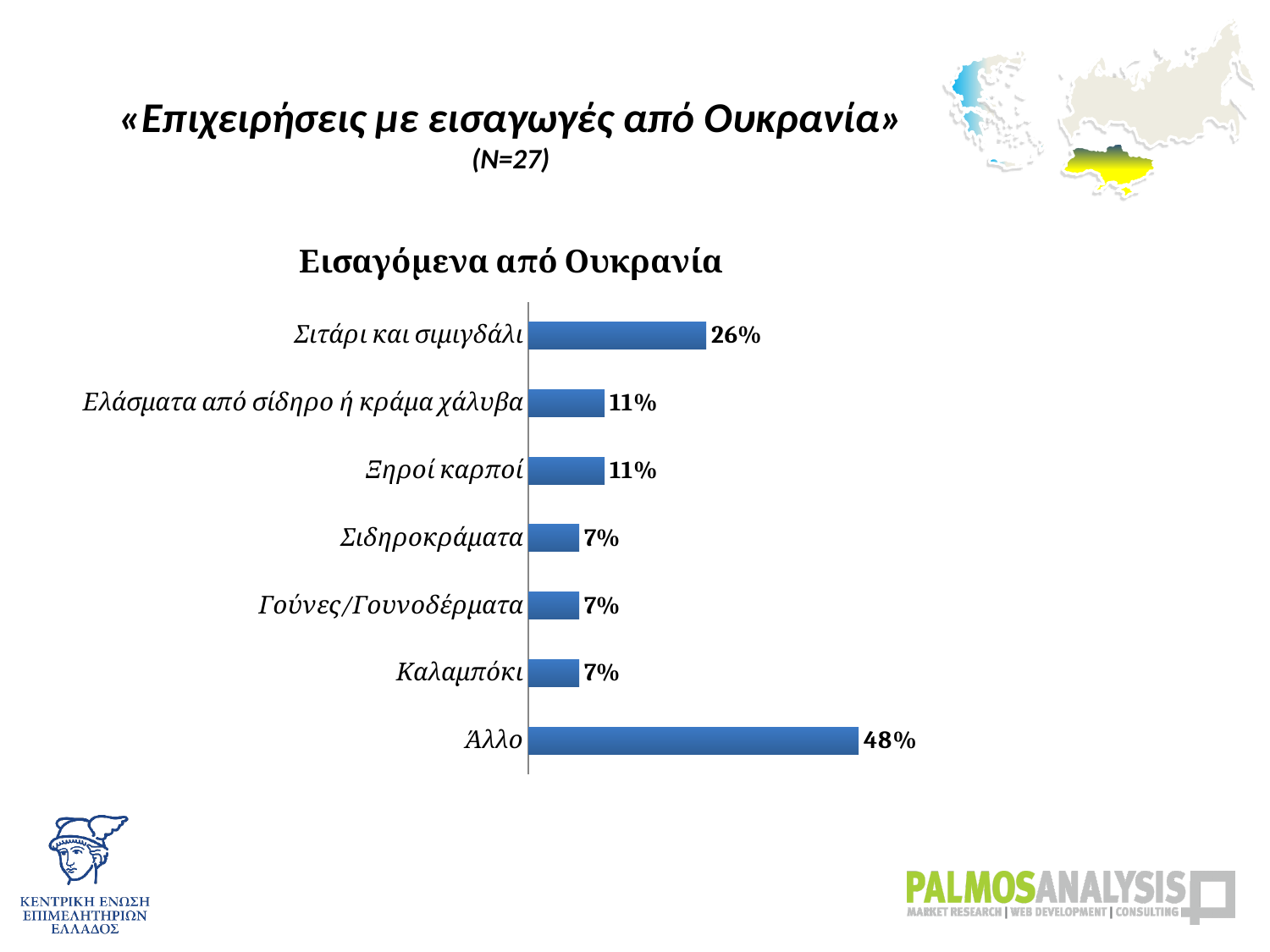
How many categories are shown in the chart? 7 Which is larger, the value for Σιτάρι και σιμιγδάλι or the value for Ξηροί καρποί? Σιτάρι και σιμιγδάλι What is the title of the chart? Εισαγόμενα από Ουκρανία Which category has the highest value? Άλλο What is the value for Ελάσματα από σίδηρο ή κράμα χάλυβα? 11% What is the value for Σιτάρι και σιμιγδάλι? 26% How many categories share the value 7%? 3 What is the difference between the values for Άλλο and Σιτάρι και σιμιγδάλι? 22% What is the value for Άλλο? 48% What is the difference between the values for Σιτάρι και σιμιγδάλι and Ξηροί καρποί? 15% What kind of chart is shown on the slide? bar chart What is the value for Καλαμπόκι? 7%